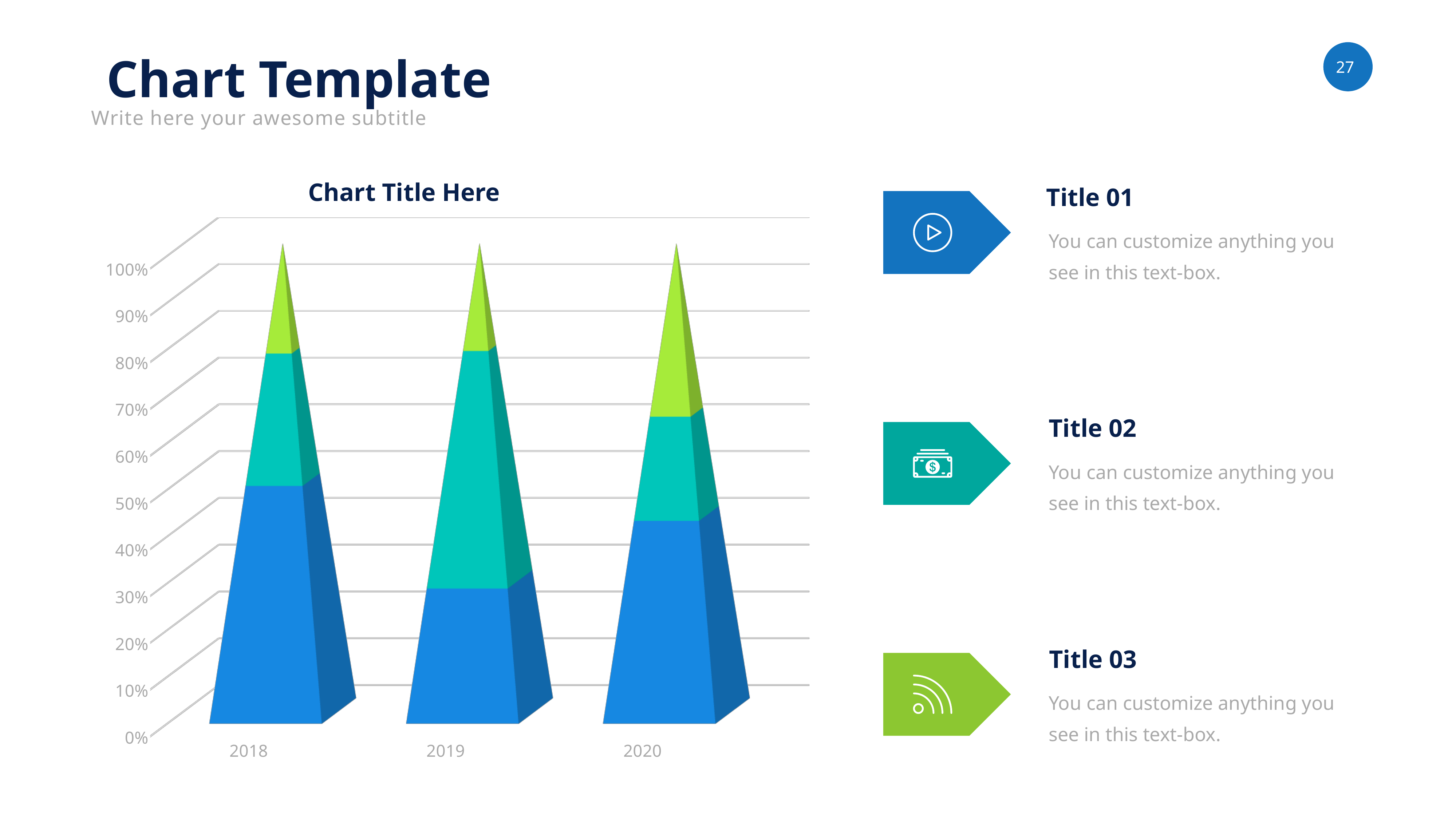
Is the top of the teal (middle) segment for 2020 above or below the 80% gridline? below What are the category labels on the x axis of the chart? 2018, 2019, 2020 Which year has the larger green (top) segment, 2018 or 2020? 2020 Is the blue (bottom) segment for 2020 greater or less than 30%? greater What is the title of the chart? Chart Title Here Which year has the smallest blue (bottom) segment? 2019 Is the blue (bottom) segment for 2019 greater or less than 40%? less What kind of chart is shown on the slide? bar chart Which year has the larger blue (bottom) segment, 2018 or 2019? 2018 Which year has the larger teal (middle) segment, 2018 or 2019? 2019 How many categories are shown on the x axis of the chart? 3